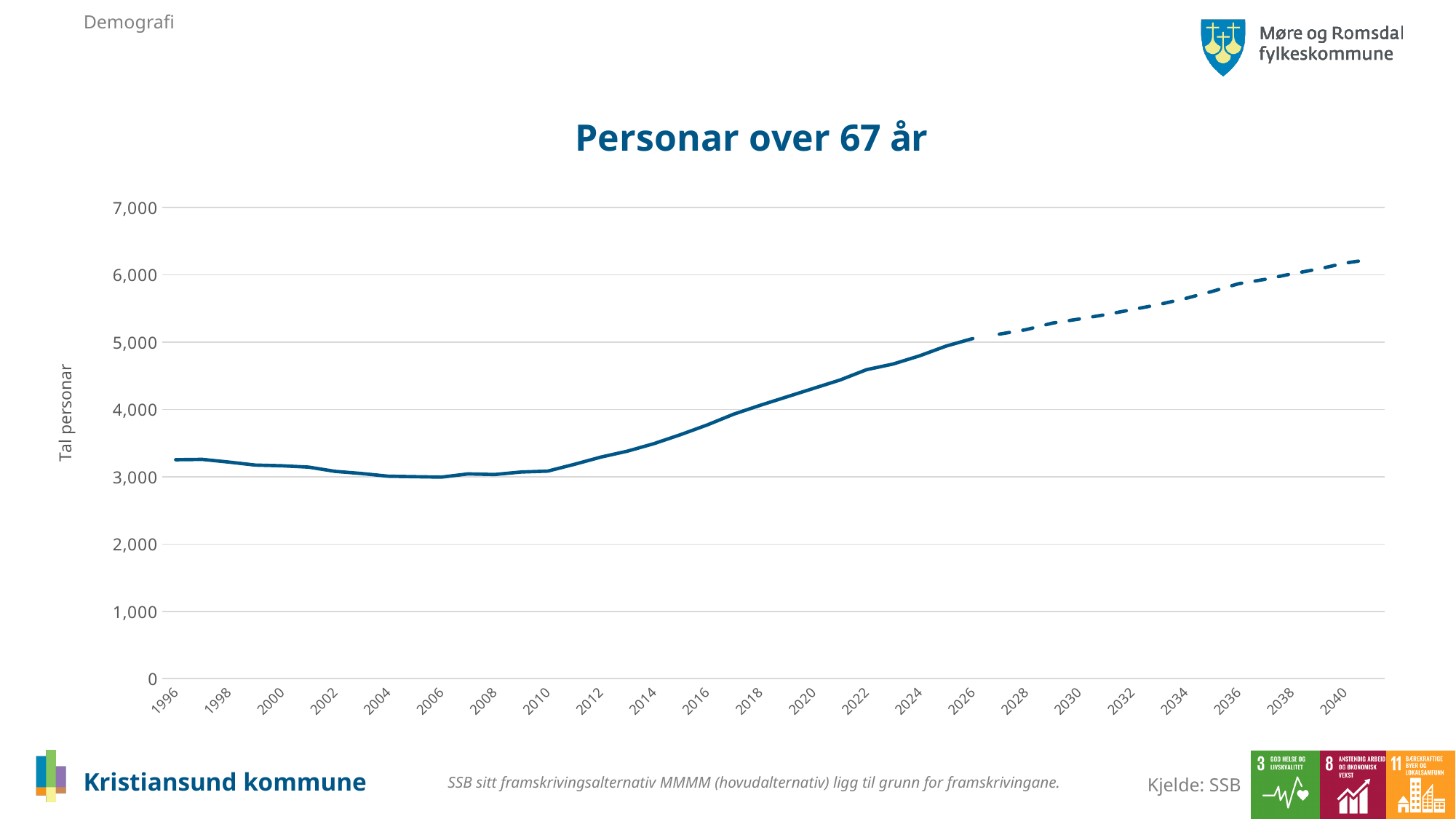
Is the value for 2014 greater or less than 4,000? less What kind of chart is shown on the slide? line chart Is the value for 1996 greater or less than 3,000? greater Is the value for 2030 greater or less than 5,000? greater What is the title of the chart? Personar over 67 år Do the values rise or fall between 2010 and 2026? rise Do the values rise or fall between 1996 and 2006? fall What is the label on the vertical axis of the chart? Tal personar